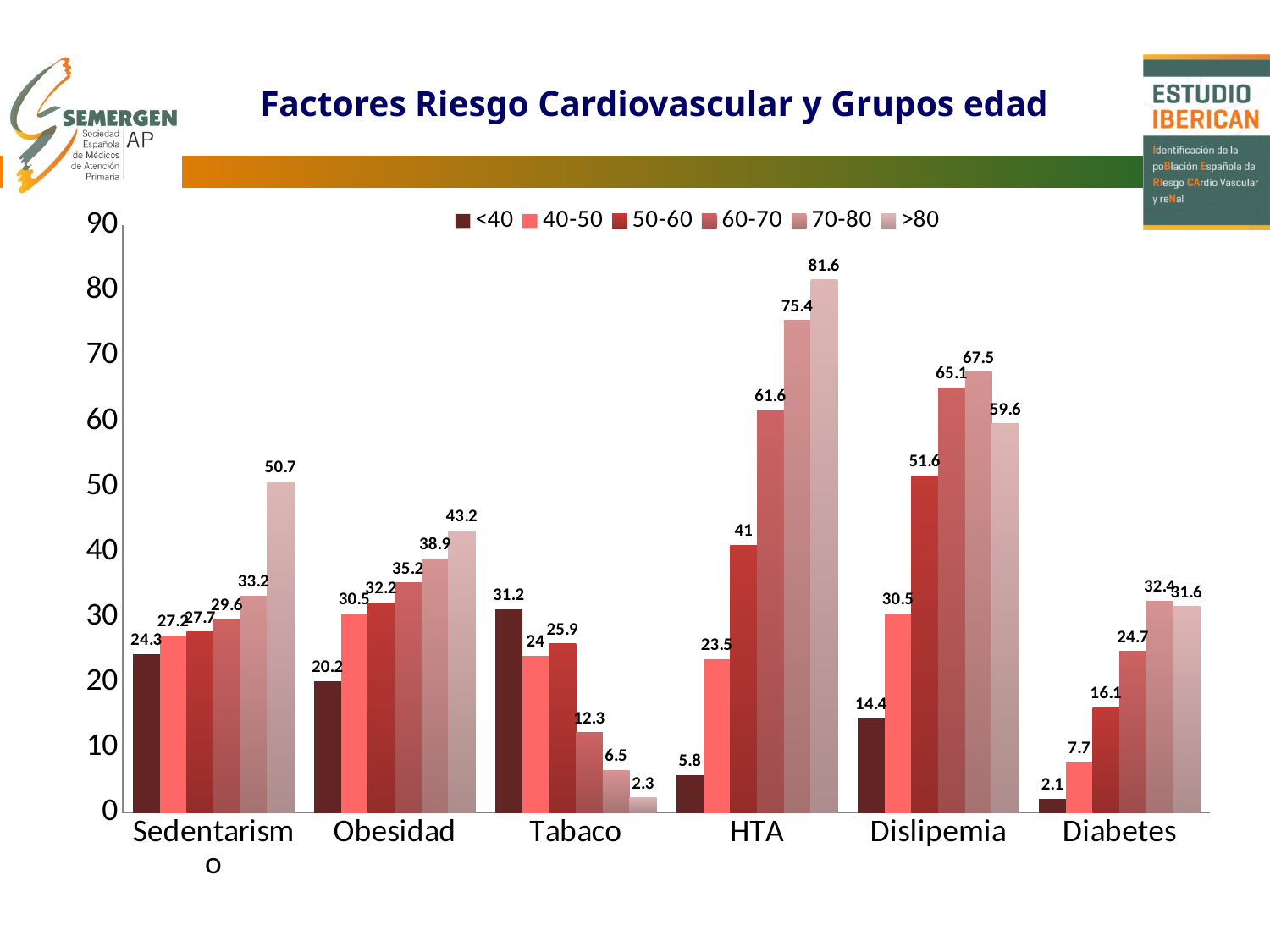
Which age group has the lowest value in the Diabetes category? <40 Which age group has the highest value in the Dislipemia category? 70-80 What is the value for the >80 age group in the HTA category? 81.6 What is the difference between the >80 and <40 values in the Sedentarismo category? 26.4 How many risk factor categories are shown on the x axis? 6 In the Tabaco category, do the values rise or fall as the age groups get older? Fall What is the value for the <40 age group in the Tabaco category? 31.2 What is the value for the 60-70 age group in the Dislipemia category? 65.1 Is the value for the 50-60 age group in the HTA category greater or less than 40? greater How many age groups does the legend list? 6 Which is larger in the Obesidad category: the 40-50 value or the 70-80 value? 70-80 What kind of chart is shown on the slide? Bar chart